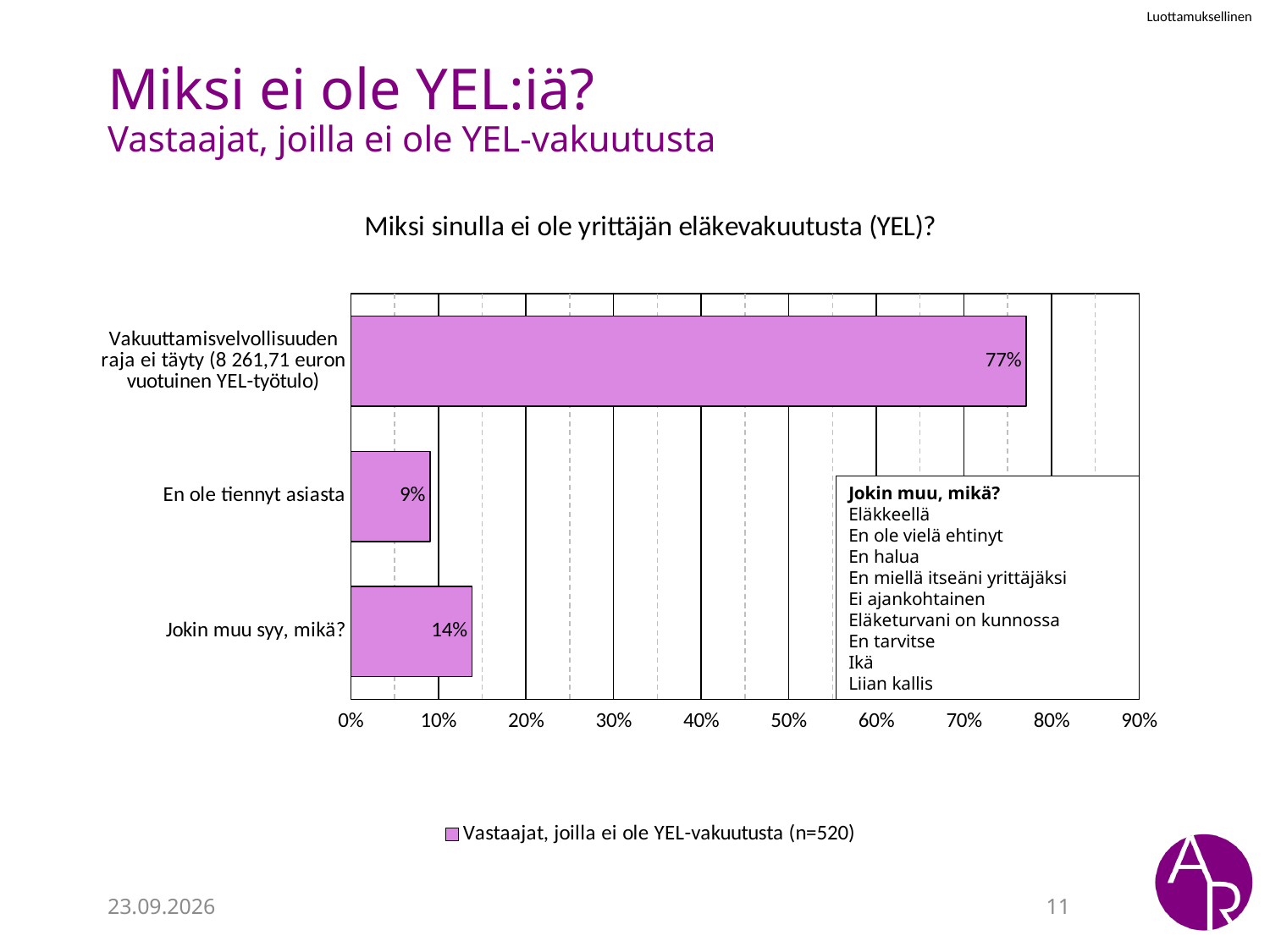
What kind of chart is shown on the slide? Bar chart Which category has the highest value? Vakuuttamisvelvollisuuden raja ei täyty (8 261,71 euron vuotuinen YEL-työtulo) What is the value for "En ole tiennyt asiasta"? 9% What is the legend entry of the chart? Vastaajat, joilla ei ole YEL-vakuutusta (n=520) Which is larger, the value for "En ole tiennyt asiasta" or the value for "Jokin muu syy, mikä?"? Jokin muu syy, mikä? What is the value for "Vakuuttamisvelvollisuuden raja ei täyty (8 261,71 euron vuotuinen YEL-työtulo)"? 77% What is the difference between the values for "Vakuuttamisvelvollisuuden raja ei täyty" and "Jokin muu syy, mikä?"? 63% What is the difference between the values for "Jokin muu syy, mikä?" and "En ole tiennyt asiasta"? 5% What is the value for "Jokin muu syy, mikä?"? 14% How many categories are shown in the chart? 3 Is the value for "Vakuuttamisvelvollisuuden raja ei täyty" greater or less than 70%? greater Which category has the lowest value? En ole tiennyt asiasta